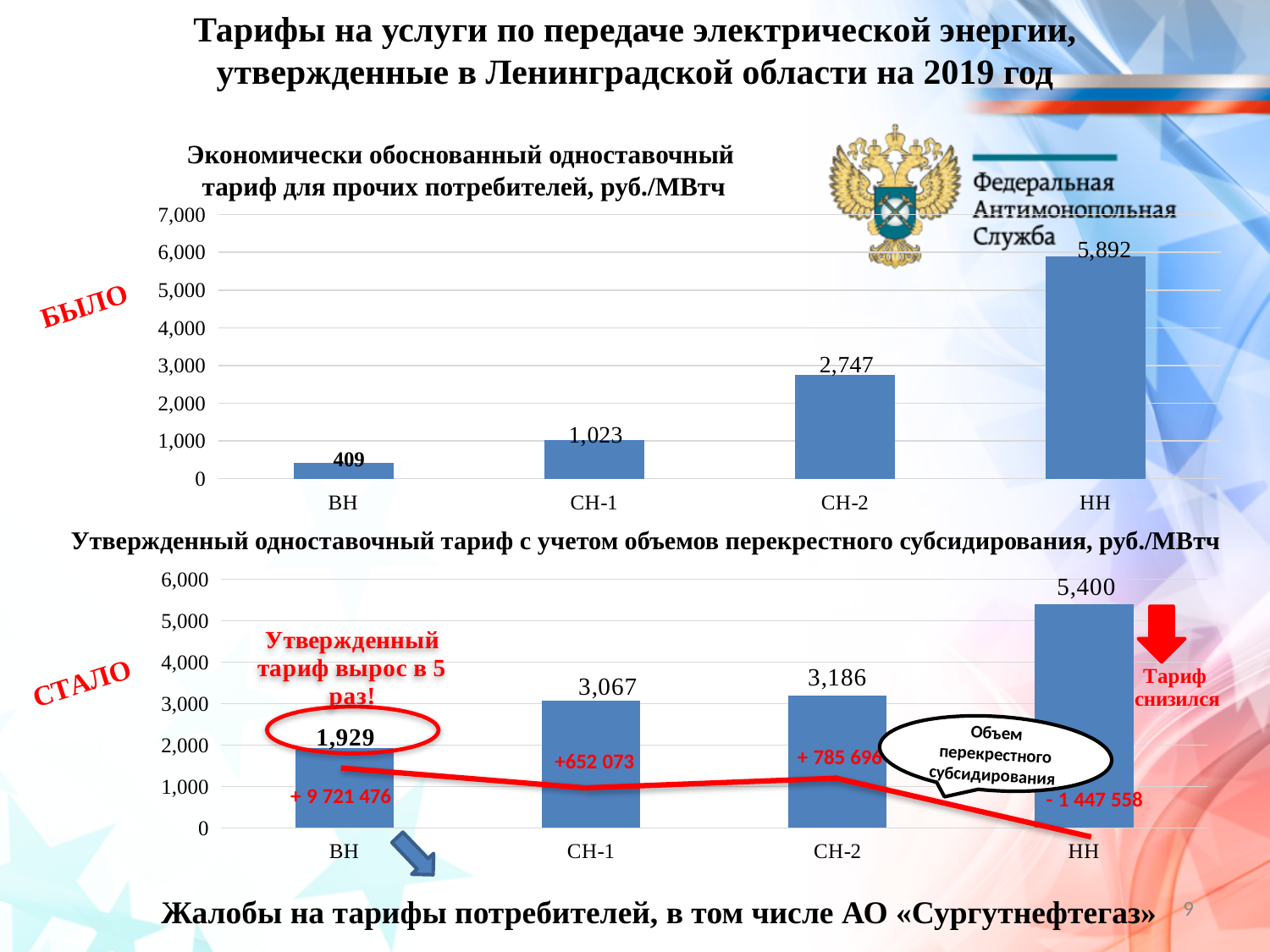
In the bottom chart, what is the value for СН-1? 3,067 In the bottom chart, what is the value for НН? 5,400 How many categories are shown on the x axis of the top chart? 4 In the top chart, what is the value for ВН? 409 In the top chart, which category has the lowest value? ВН In the top chart, what is the difference between the values for СН-2 and СН-1? 1,724 In the top chart, what is the value for НН? 5,892 What type of chart is the bottom chart? Bar chart In the bottom chart, which category has the highest value? НН In the top chart, do the values rise or fall from ВН to НН along the x axis? Rise In the bottom chart, what is the difference between the values for НН and ВН? 3,471 In the bottom chart, which is larger: the value for СН-2 or the value for ВН? СН-2